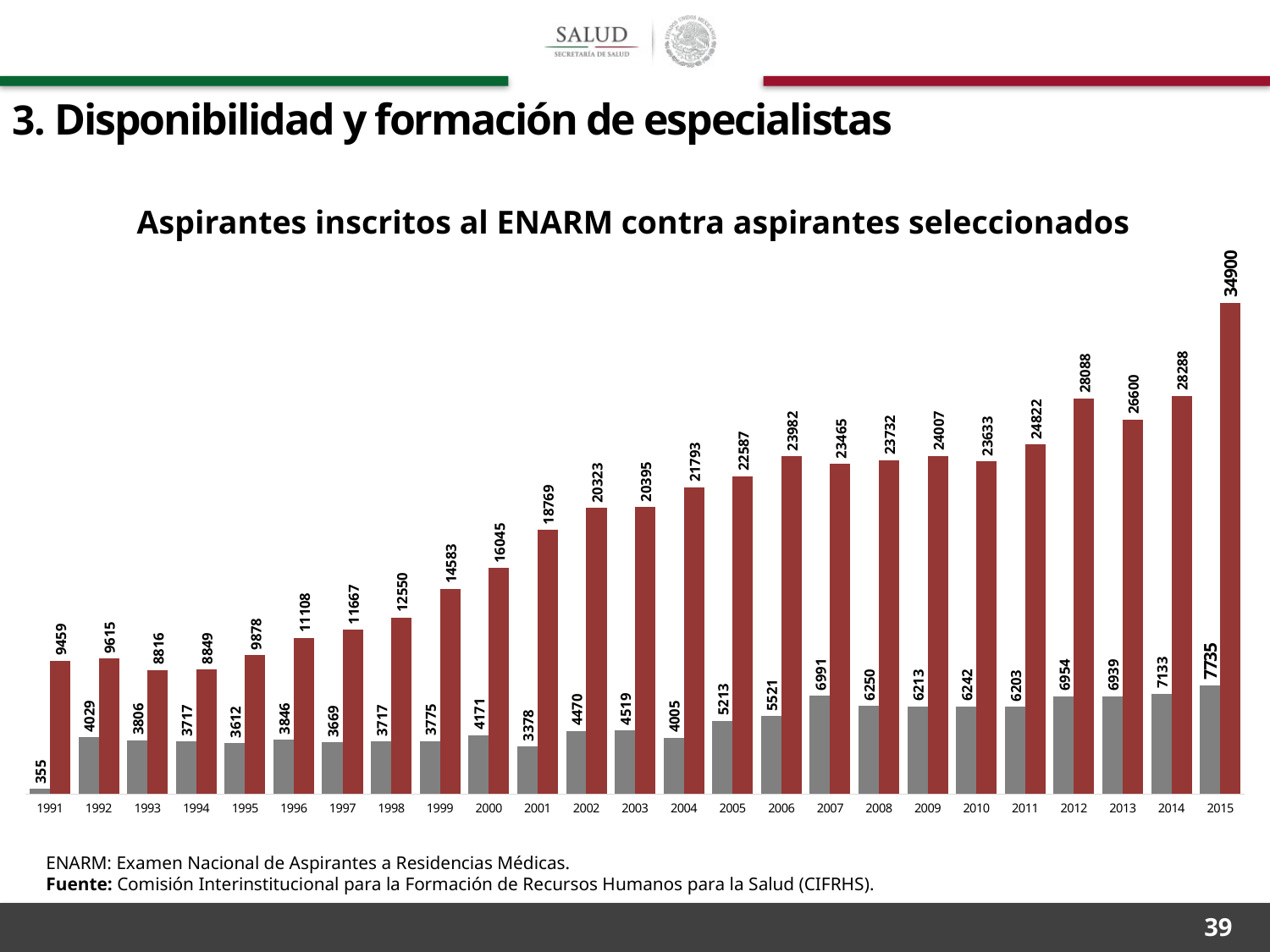
Do the red bars generally rise or fall from 1991 to 2015? Rise What is the value of the red bar for 2015? 34900 Which year has the highest red bar? 2015 By how much does the red bar for 2014 exceed the red bar for 2013? 1688 What is the title of the chart? Aspirantes inscritos al ENARM contra aspirantes seleccionados Which year has the lowest gray bar? 1991 What kind of chart is shown on the slide? Bar chart How many years are shown on the x axis? 25 What is the value of the gray bar for 1991? 355 What is the value of the gray bar for 2007? 6991 Which year has the larger red bar, 2012 or 2013? 2012 What is the difference between the red bar and the gray bar for 2015? 27165